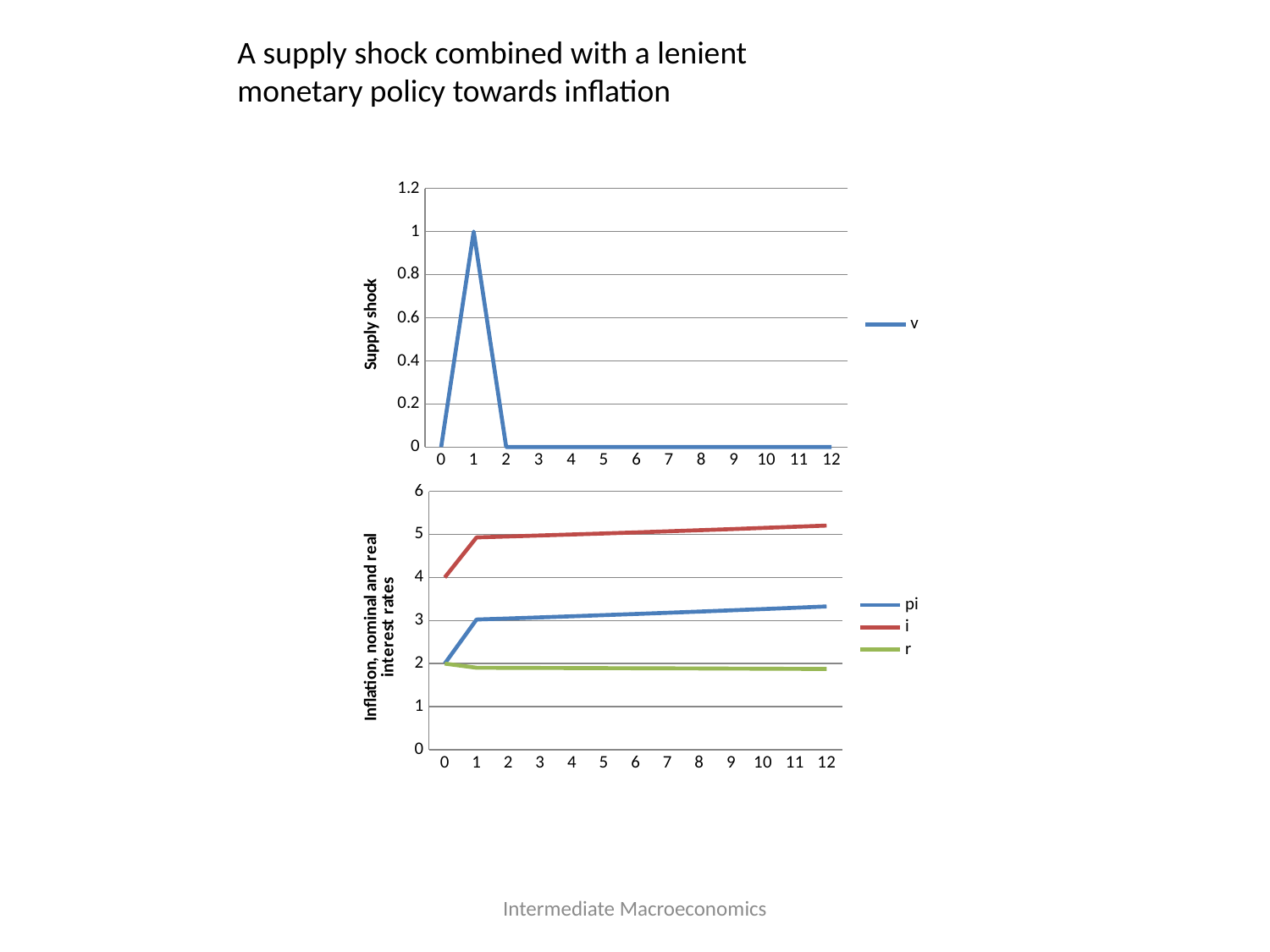
In the top chart, what is the value of v at period 1? 1 In the top chart, what is the value of v at period 0? 0 What is the y-axis label of the top chart? Supply shock In the bottom chart, is the value of r at period 12 greater or less than 2? less How many periods are shown on the x axis of the top chart? 13 In the bottom chart, what is the value of i at period 0? 4 How many series does the legend of the bottom chart list? 3 In the bottom chart, what is the value of pi at period 0? 2 In the bottom chart, is the value of i at period 12 greater or less than 5? greater In the bottom chart, which series is higher at period 12, i or pi? i In the top chart, at which period does v reach its highest value? 1 What kind of chart is the top chart on the slide? line chart